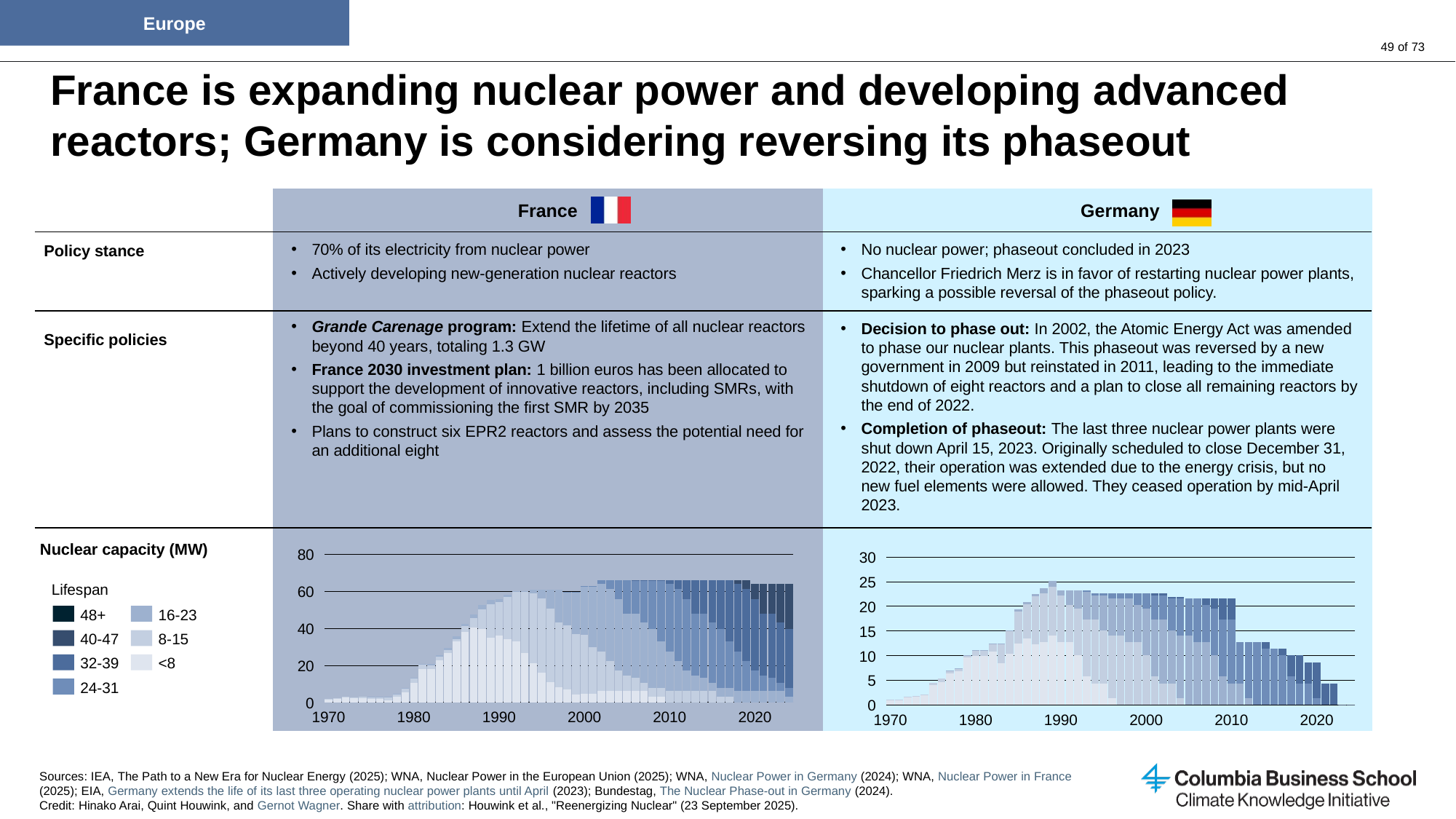
In the France nuclear capacity chart, is the value for 2020 greater or less than 40? greater In the France nuclear capacity chart, do the values rise or fall between 1970 and 1990? rise In the Germany nuclear capacity chart, is the value for 1975 greater or less than 10? less Which country's nuclear capacity chart shows the larger value in 2020, France or Germany? France How many lifespan categories does the legend list for the nuclear capacity charts? 7 In the France nuclear capacity chart, is the value for 1990 greater or less than 40? greater What is the highest value shown on the y axis of the Germany nuclear capacity chart? 30 What kind of chart is used to show France's nuclear capacity? bar chart In the Germany nuclear capacity chart, do the values rise or fall between 2010 and 2020? fall